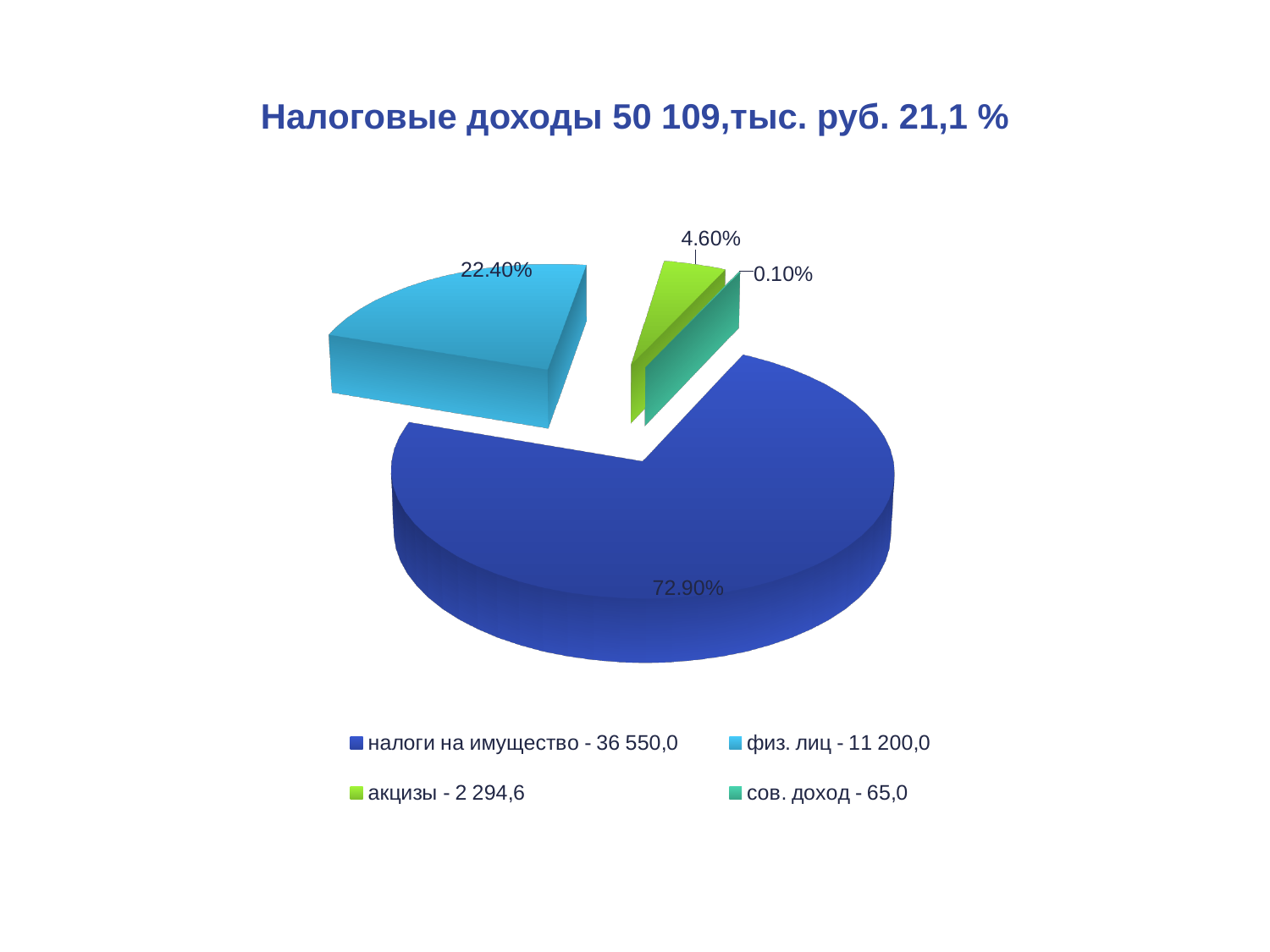
How many entries does the legend list? 4 Which category has the smallest slice of the pie? сов. доход - 65,0 What is the title of the chart? Налоговые доходы 50 109,тыс. руб. 21,1 % What share of the pie does the slice for 'физ. лиц - 11 200,0' represent? 22.40% Which slice is larger: 'физ. лиц - 11 200,0' or 'акцизы - 2 294,6'? физ. лиц - 11 200,0 What is the difference in percentage points between the 'налоги на имущество' slice and the 'физ. лиц' slice? 50.50% What share of the pie does the slice for 'налоги на имущество - 36 550,0' represent? 72.90% How many slices does the pie chart have? 4 What share of the pie does the slice for 'акцизы - 2 294,6' represent? 4.60% Which category has the largest slice of the pie? налоги на имущество - 36 550,0 What kind of chart is shown on the slide? Pie chart